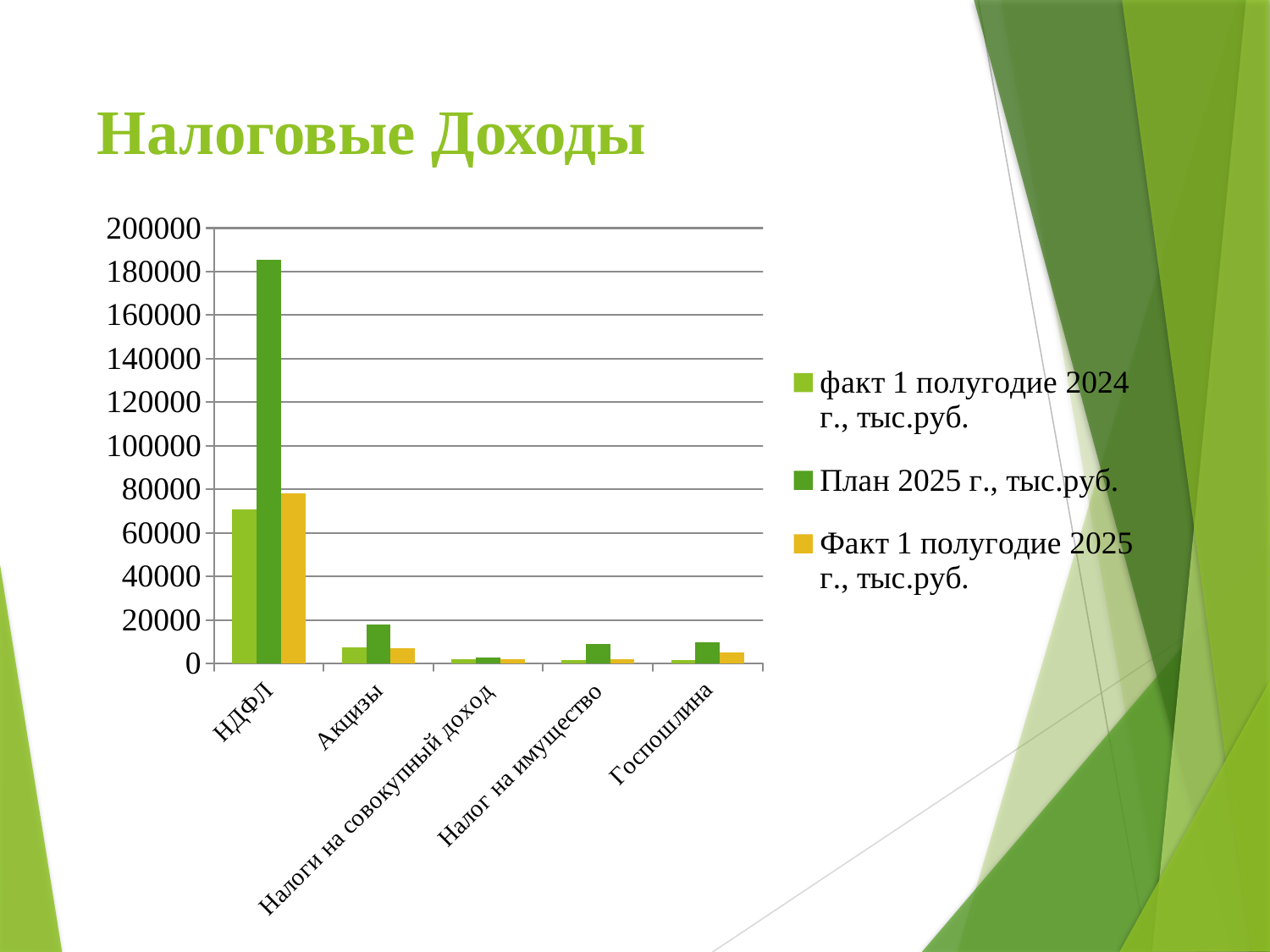
What is the title of the slide with the chart? Налоговые Доходы Is the value of План 2025 г. for Акцизы greater or less than 40000? less For НДФЛ, which is larger: факт 1 полугодие 2024 г. or План 2025 г.? План 2025 г. How many series does the legend list? 3 Which series has the tallest bar for НДФЛ? План 2025 г., тыс.руб. Is the value of План 2025 г. for НДФЛ greater or less than 180000? greater What kind of chart is shown on the slide? bar chart Is the value of факт 1 полугодие 2024 г. for НДФЛ greater or less than 60000? greater For Акцизы, which is larger: План 2025 г. or Факт 1 полугодие 2025 г.? План 2025 г. Which category has the highest values in the chart? НДФЛ How many categories are shown on the x axis? 5